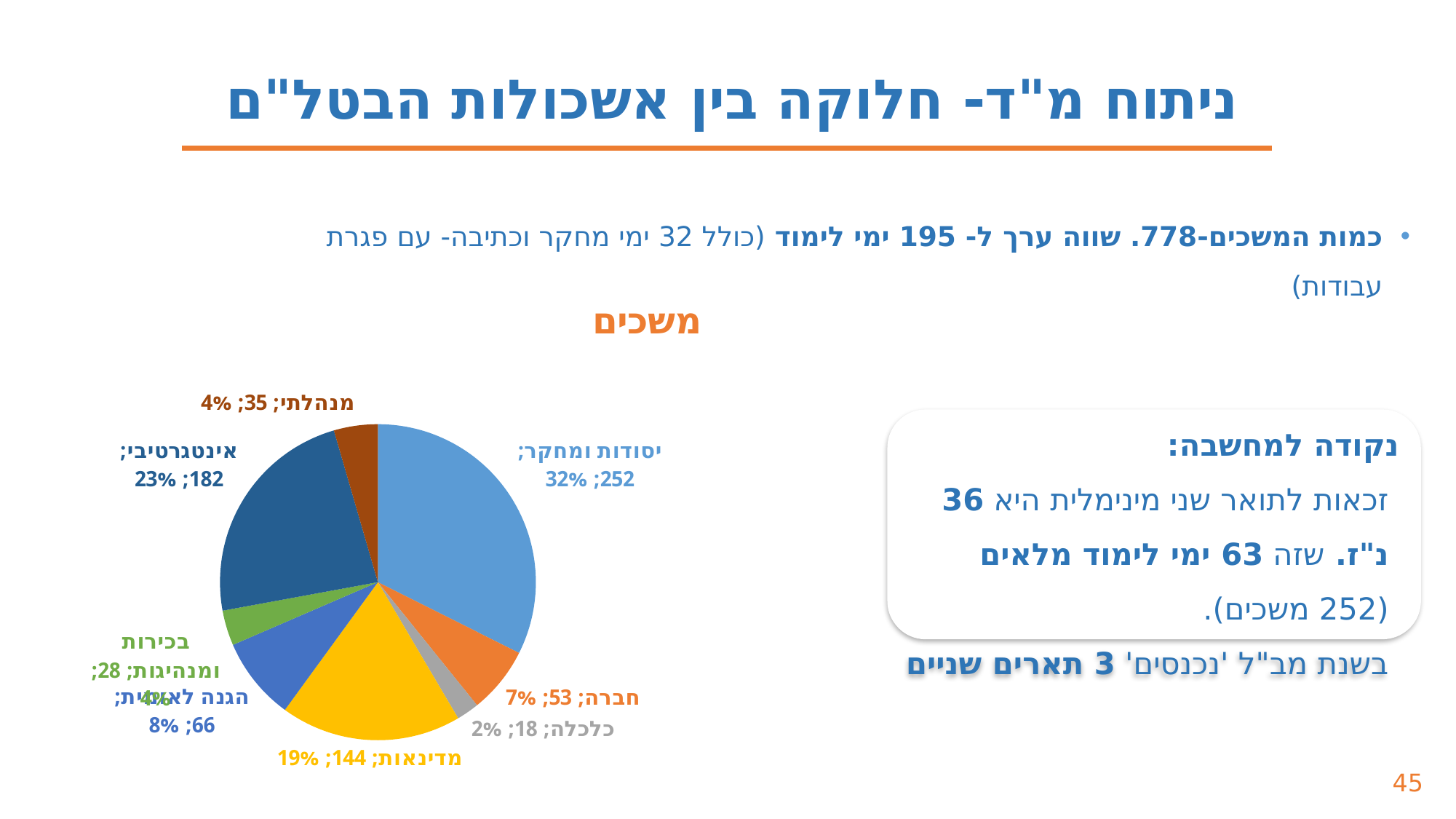
What is the difference between the values for אינטגרטיבי and מדינאות? 38 What share of the pie does הגנה לאומית represent? 8% Which is larger, the value for מנהלתי or the value for בכירות ומנהיגות? מנהלתי How many slices does the pie chart have? 8 What is the title of the chart? משכים What is the value for יסודות ומחקר? 252 Which category has the largest slice? יסודות ומחקר What share of the pie does חברה represent? 7% What is the value for מדינאות? 144 What is the value for אינטגרטיבי? 182 Which category has the smallest slice? כלכלה What kind of chart is shown on the slide? pie chart